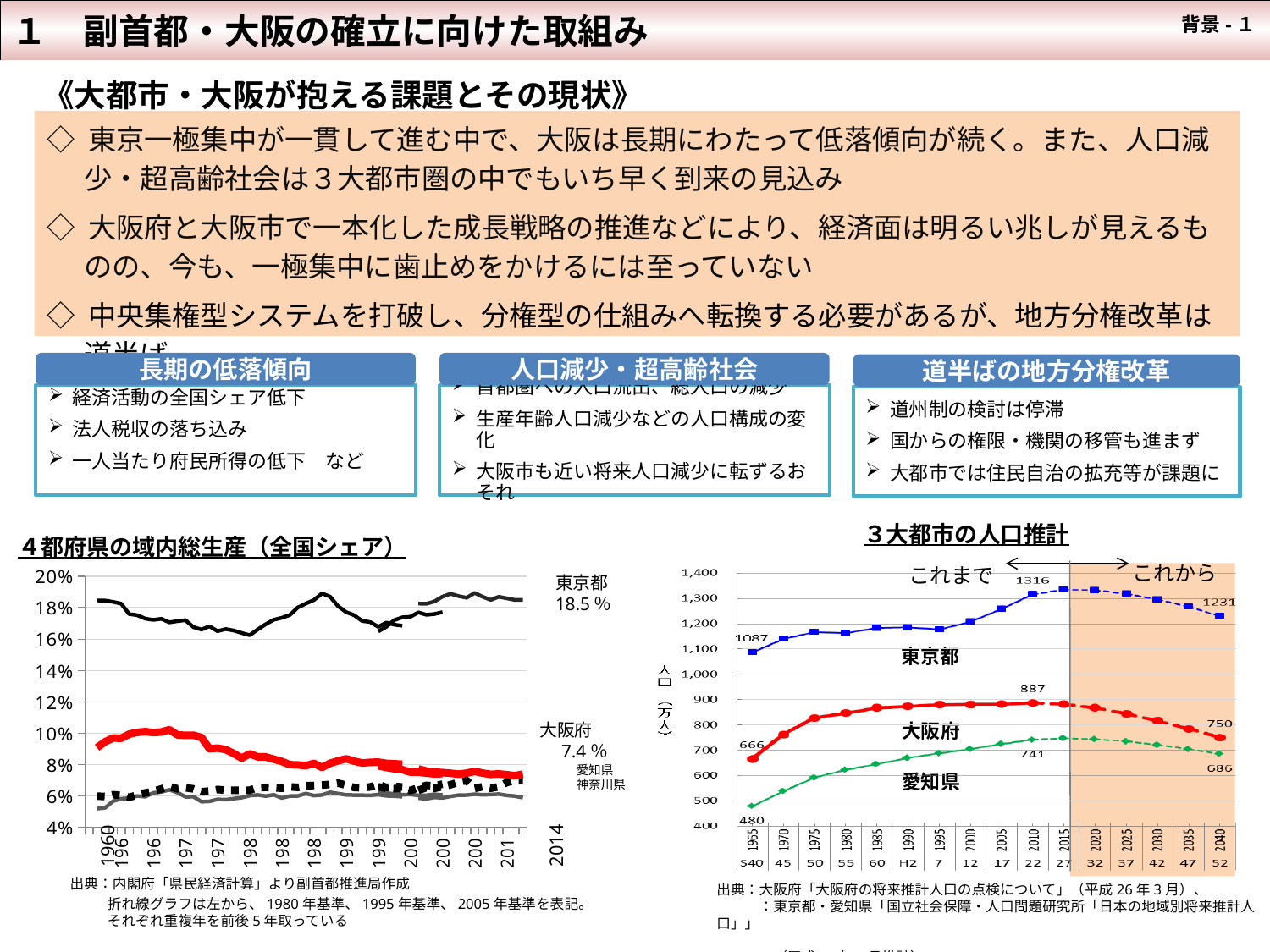
In the ３大都市の人口推計 chart, which prefecture has the lowest labelled value in 1965? 愛知県 In the ４都府県の域内総生産（全国シェア） chart, what is the labelled share for 大阪府? 7.4％ In the ４都府県の域内総生産（全国シェア） chart, does the 大阪府 line rise or fall from the 1970s to 2014? fall What type of chart is the ３大都市の人口推計 chart? line chart In the ３大都市の人口推計 chart, what is the difference between the 2015 and 2040 labelled values for 東京都? 85 In the ３大都市の人口推計 chart, which of the three prefectures has the highest population in 2015? 東京都 In the ３大都市の人口推計 chart, is the 2040 value for 大阪府 larger or smaller than the 2040 value for 愛知県? larger In the ３大都市の人口推計 chart, what is the labelled population value for 大阪府 in 2040? 750 In the ３大都市の人口推計 chart, what is the difference between the 1965 labelled values for 大阪府 and 愛知県? 186 In the ３大都市の人口推計 chart, what is the labelled population value for 愛知県 in 1965? 480 In the ４都府県の域内総生産（全国シェア） chart, what is the labelled share for 東京都? 18.5％ In the ３大都市の人口推計 chart, what is the labelled population value for 東京都 in 2015? 1316